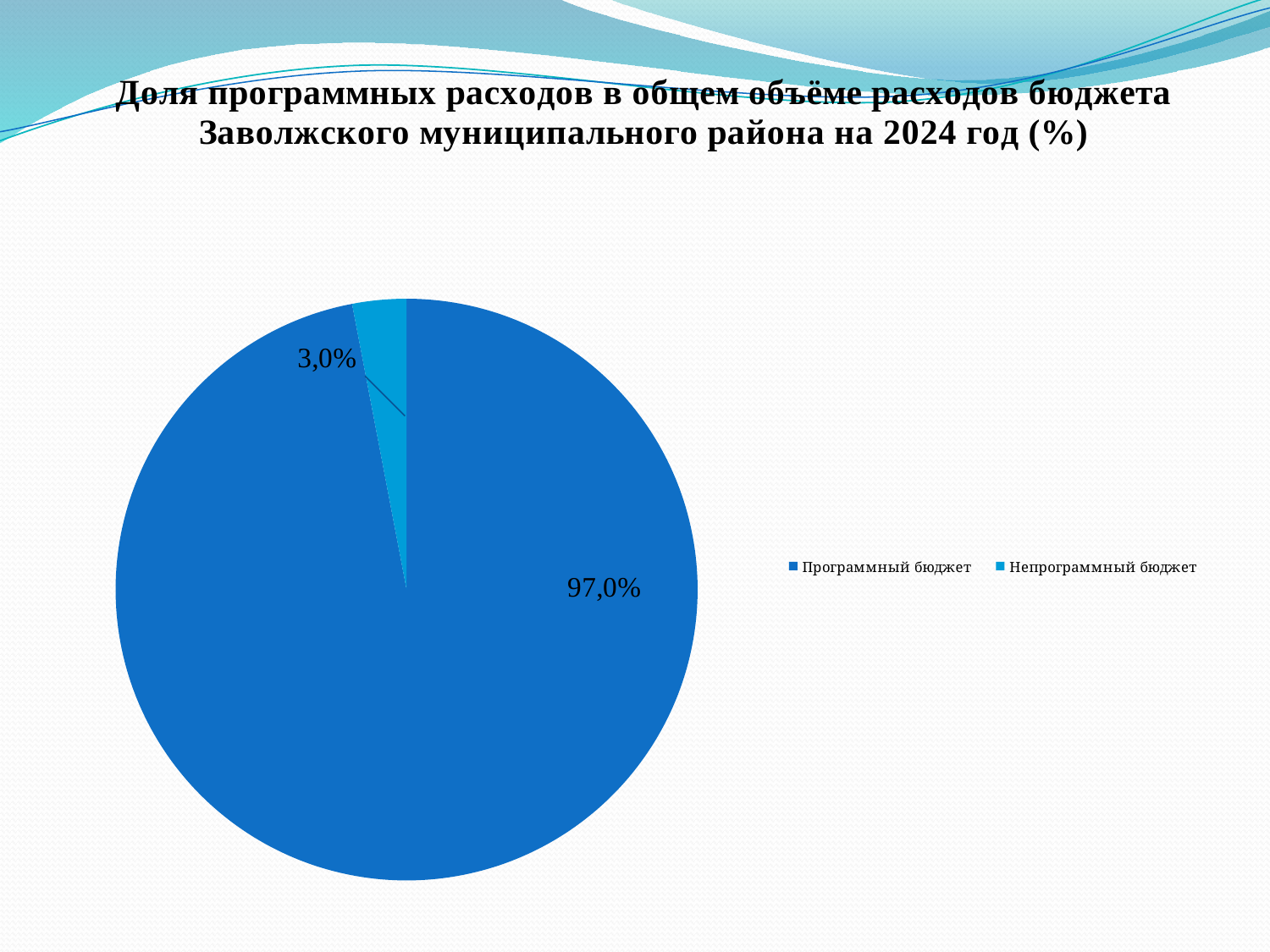
What is the value for Программный бюджет? 97,0% What share of the pie does Непрограммный бюджет take? 3,0% What kind of chart is shown on the slide? pie chart How many entries does the legend list? 2 Which is larger, Программный бюджет or Непрограммный бюджет? Программный бюджет Which category has the largest slice? Программный бюджет What is the value for Непрограммный бюджет? 3,0% What year does the chart title refer to? 2024 How many slices does the pie chart have? 2 Which category has the smallest slice? Непрограммный бюджет What is the difference between the values for Программный бюджет and Непрограммный бюджет? 94,0% Which legend entry is shown in the lighter blue colour? Непрограммный бюджет